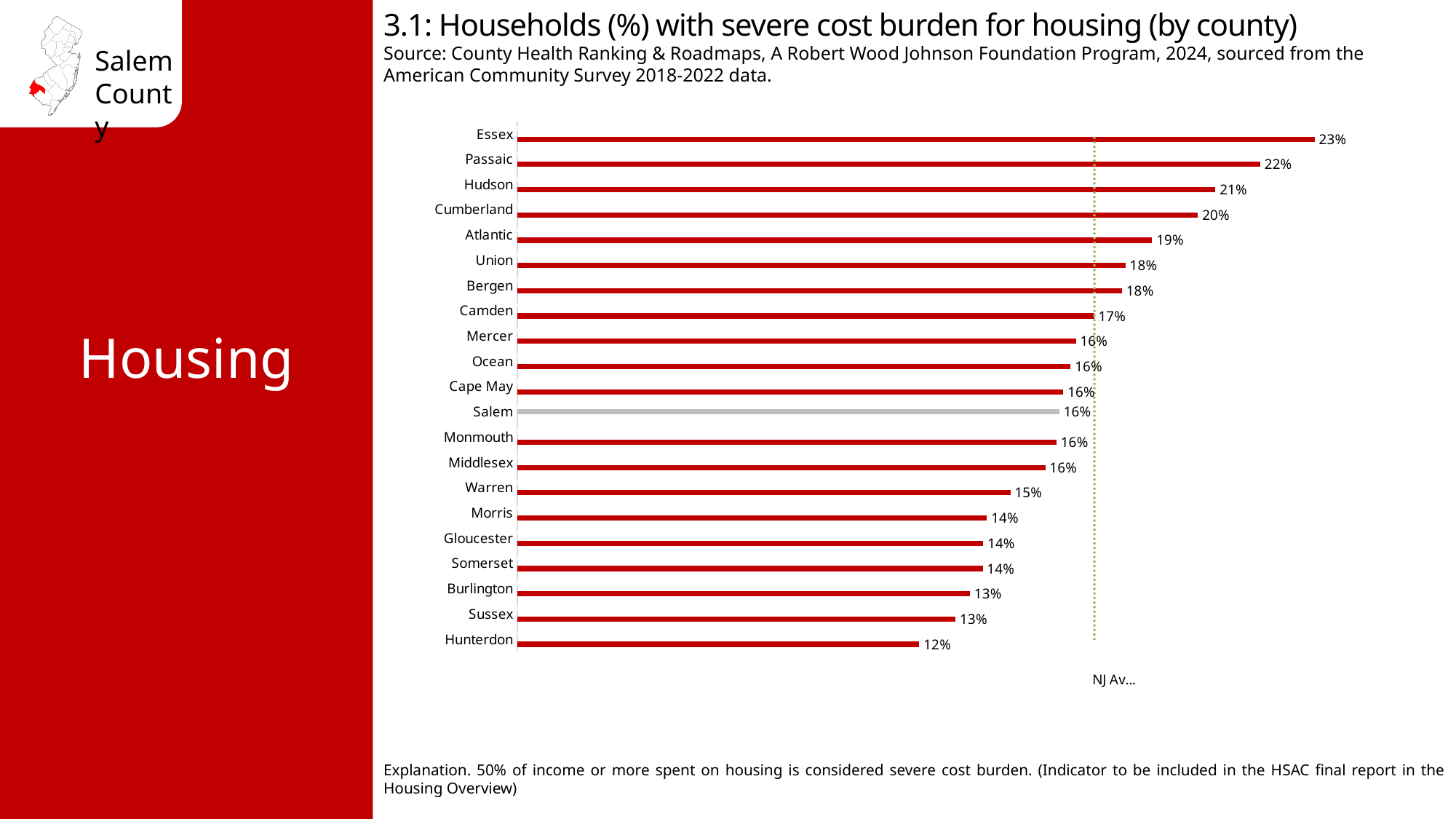
What is the difference between the values for Passaic and Salem? 6 percentage points Which county has the lowest percentage of households with severe cost burden? Hunterdon What is the value shown for Cumberland? 20% What is the value for Salem in the chart? 16% Which has a higher value, Warren or Morris? Warren How many counties are shown in the chart? 21 Which county has the highest percentage of households with severe cost burden? Essex Which has a higher value, Cumberland or Atlantic? Cumberland What percentage of households in Essex have a severe housing cost burden? 23% Which county's bar is shown in grey instead of red? Salem What kind of chart is shown on the slide? Bar chart What is the difference between the values for Essex and Hunterdon? 11 percentage points